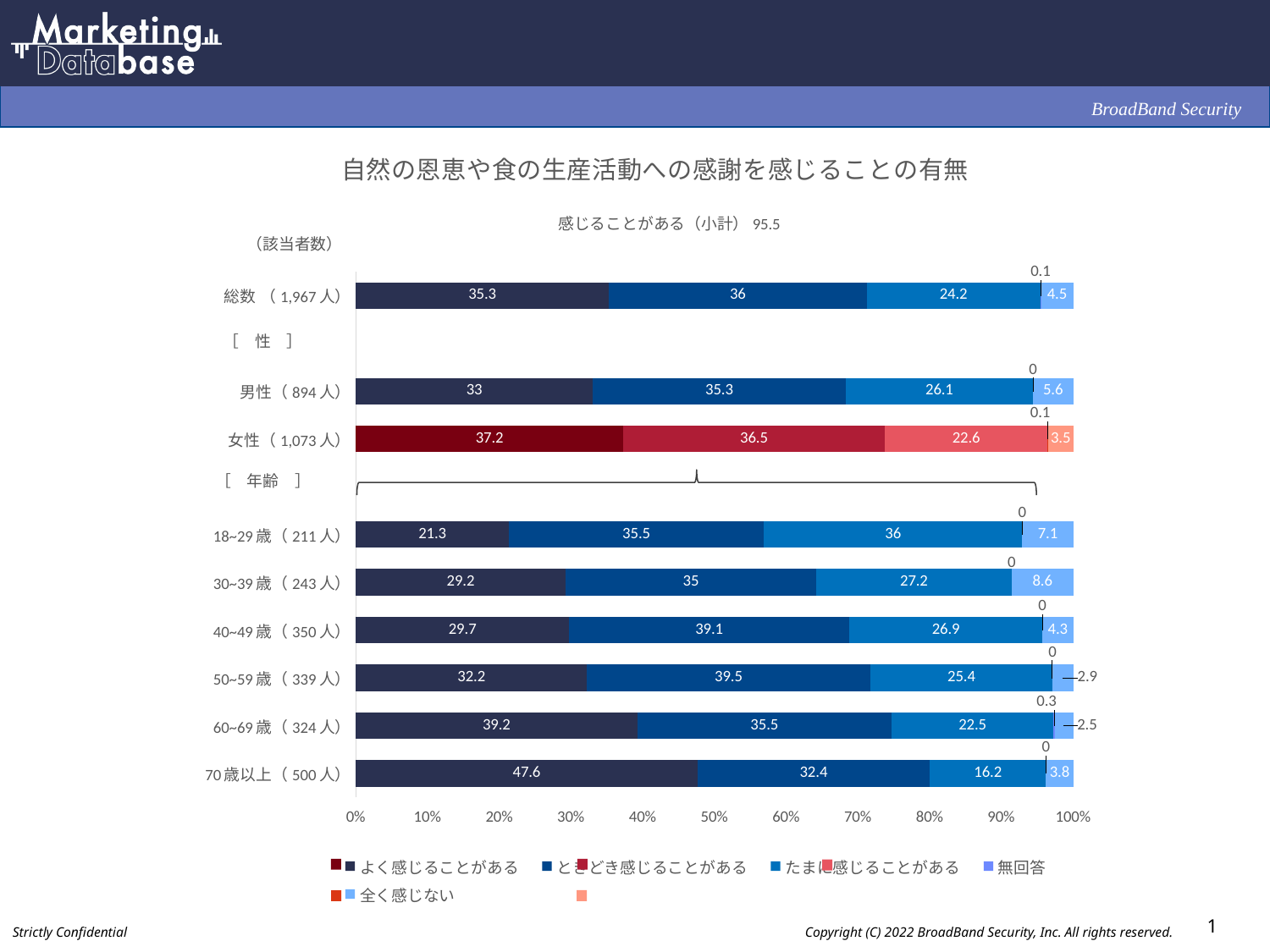
Which category has the lowest value for よく感じることがある? 18~29歳 (211人) What is the title of the chart? 自然の恩恵や食の生産活動への感謝を感じることの有無 What is the value of 無回答 for 30~39歳 (243人)? 0 How many category bars are plotted in the chart? 9 What is the value of たまに感じることがある for 18~29歳 (211人)? 36 What is the value of ときどき感じることがある for 総数 (1,967人)? 36 What kind of chart is shown on the slide? Stacked bar chart What is the difference between the よく感じることがある values for 女性 (1,073人) and 男性 (894人)? 4.2 What is the value of よく感じることがある for 70歳以上 (500人)? 47.6 What is the 感じることがある (小計) value shown above the chart? 95.5 Which category has the highest value for よく感じることがある? 70歳以上 (500人) Which is larger, the ときどき感じることがある value for 50~59歳 (339人) or for 40~49歳 (350人)? 50~59歳 (339人)